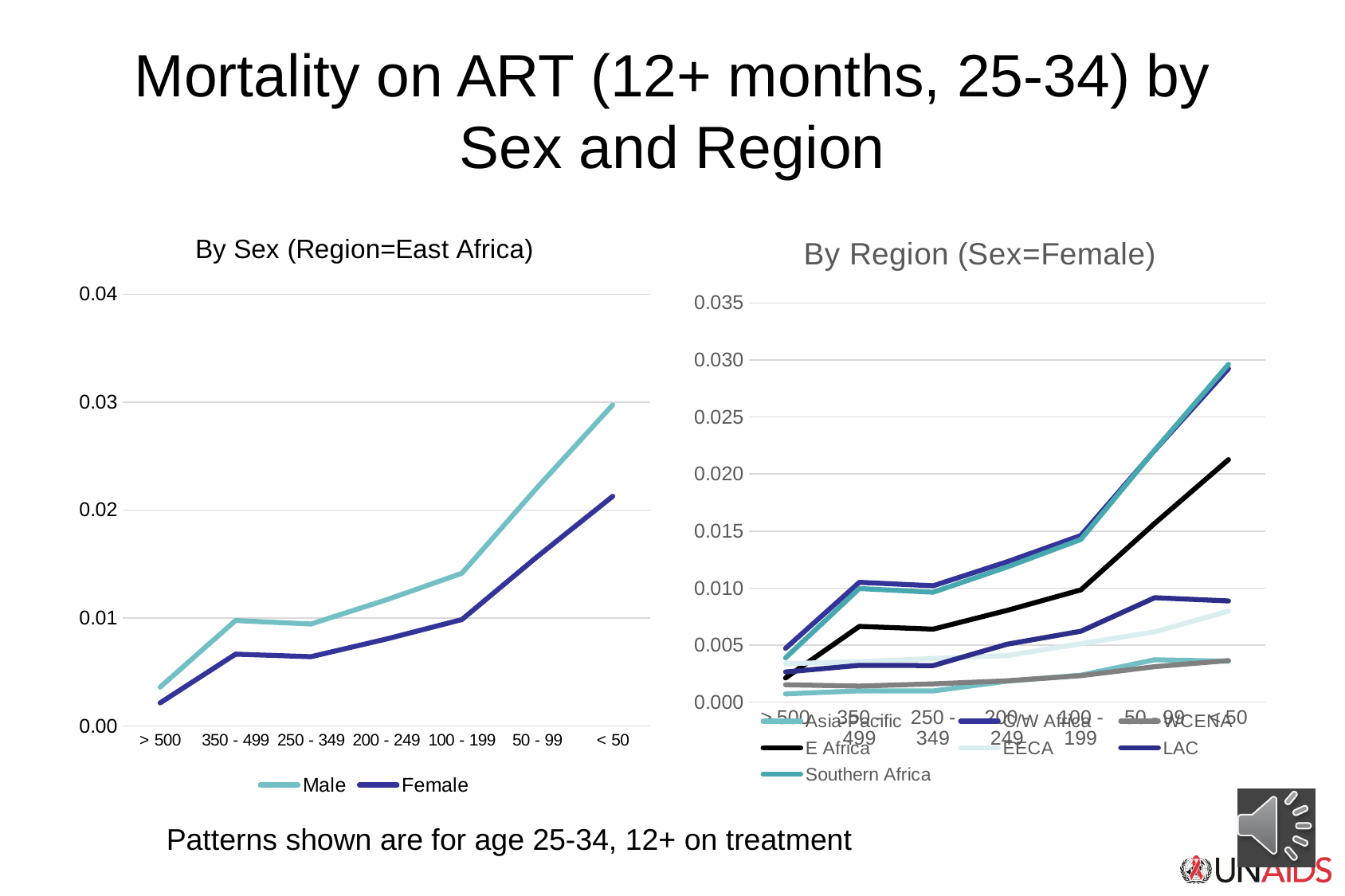
In the 'By Sex (Region=East Africa)' chart, which category has the highest Male value? < 50 What kind of chart is the 'By Sex (Region=East Africa)' chart? line chart In the 'By Sex (Region=East Africa)' chart, which category has the lowest Female value? > 500 How many series does the legend of the 'By Region (Sex=Female)' chart list? 7 In the 'By Region (Sex=Female)' chart, is the Southern Africa value at < 50 greater or less than 0.025? greater What is the title of the chart on the right of the slide? By Region (Sex=Female) How many series does the legend of the 'By Sex (Region=East Africa)' chart list? 2 In the 'By Sex (Region=East Africa)' chart, is the Male value for 100 - 199 greater or less than 0.01? greater In the 'By Sex (Region=East Africa)' chart, is the Male value at < 50 larger or smaller than the Female value at < 50? larger How many categories are shown on the x axis of the 'By Sex (Region=East Africa)' chart? 7 In the 'By Region (Sex=Female)' chart, is the E Africa value at < 50 larger or smaller than the WCENA value at < 50? larger In the 'By Sex (Region=East Africa)' chart, do the Male values generally rise or fall from > 500 to < 50? rise